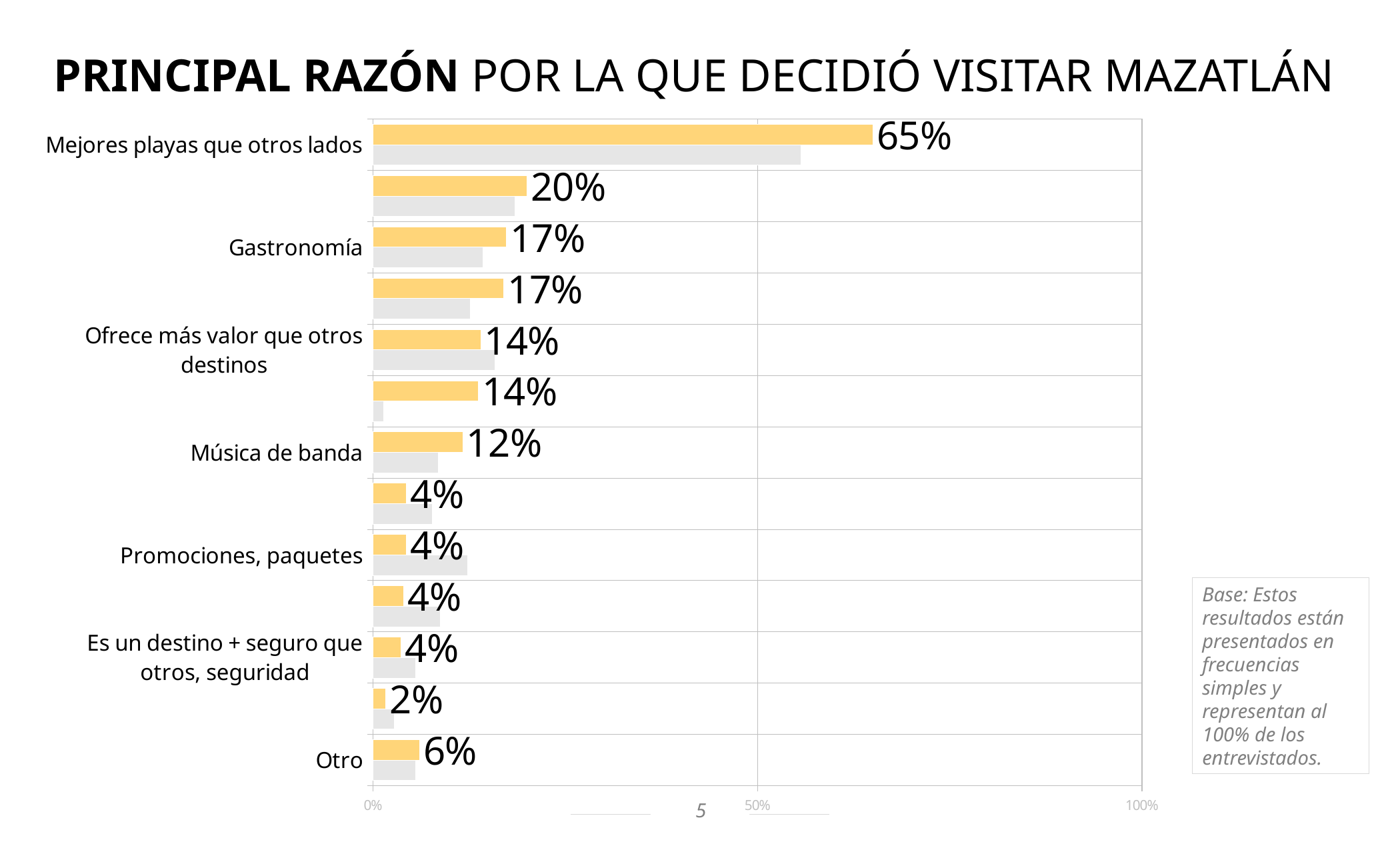
What percentage is shown for "Gastronomía"? 17% What is the value labelled for "Música de banda"? 12% What is the value shown for "Mejores playas que otros lados"? 65% Which reason has the highest percentage? Mejores playas que otros lados What percentage is shown for "Ofrece más valor que otros destinos"? 14% What kind of chart is shown on the slide? Bar chart Is the grey bar for "Mejores playas que otros lados" greater or less than 50%? greater What is the value shown for "Promociones, paquetes"? 4% How many yellow bars with data labels are in the chart? 13 What is the difference between the values for "Mejores playas que otros lados" and "Gastronomía"? 48% Which has a larger value, "Música de banda" or "Otro"? Música de banda What percentage is shown for "Otro"? 6%